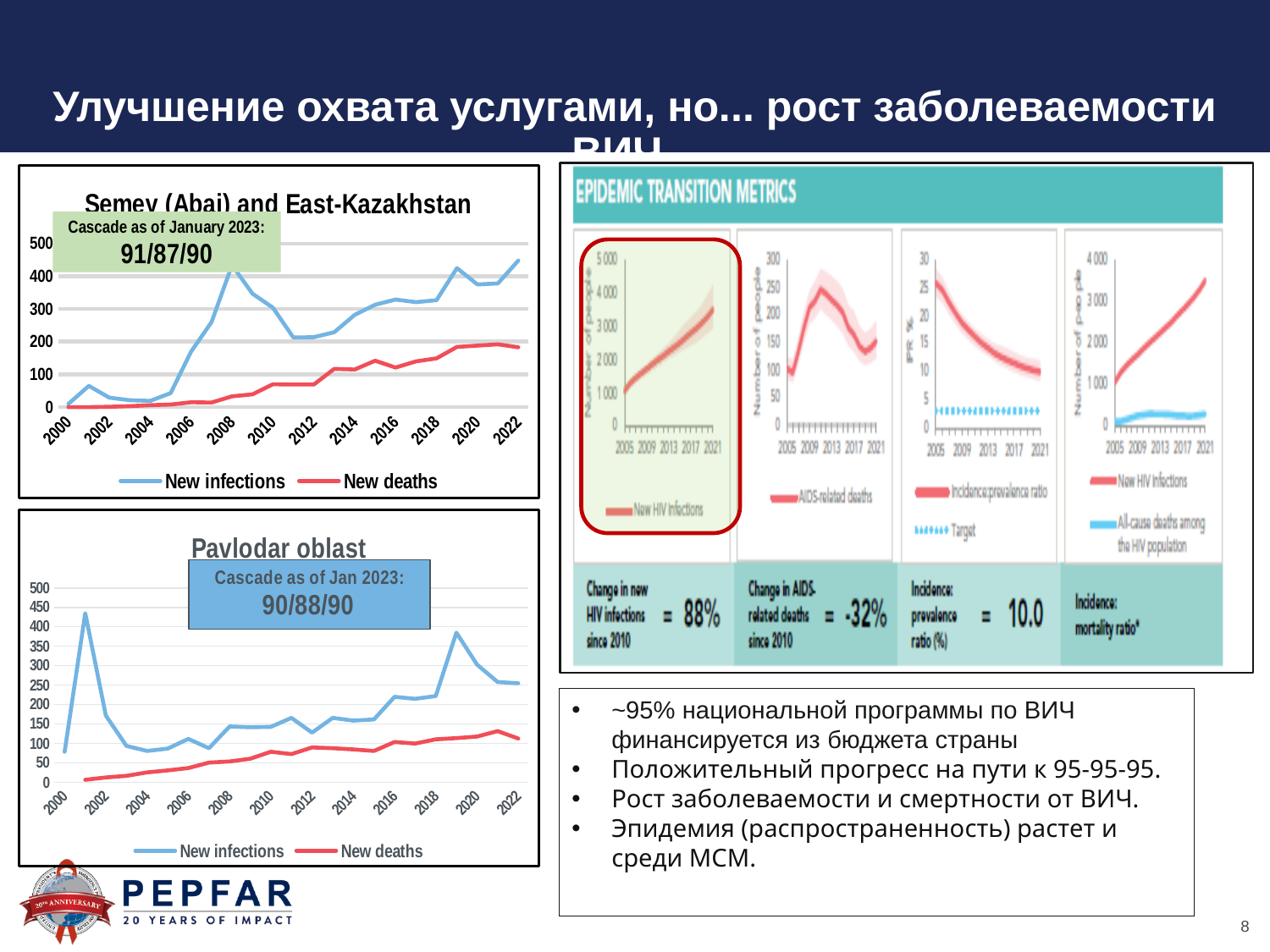
In the 'Semey (Abai) and East-Kazakhstan' chart, is the value for New infections in 2022 greater or less than 400? greater What kind of chart is the 'Semey (Abai) and East-Kazakhstan' chart? Line chart In the 'Pavlodar oblast' chart, is the value for New deaths in 2022 greater or less than 150? less In the 'Pavlodar oblast' chart, in which year do New infections reach their highest value? 2001 In the 'Epidemic Transition Metrics' panel, what is the change in new HIV infections since 2010? 88% In the 'Pavlodar oblast' chart, is the value for New infections in 2022 greater or less than 200? greater In the 'Semey (Abai) and East-Kazakhstan' chart, which series is higher in 2022, New infections or New deaths? New infections In the 'Semey (Abai) and East-Kazakhstan' chart, do New deaths generally rise or fall from 2000 to 2022? Rise In the 'Epidemic Transition Metrics' panel, what is the change in AIDS-related deaths since 2010? -32% What cascade value as of January 2023 is shown on the 'Semey (Abai) and East-Kazakhstan' chart? 91/87/90 How many series does the legend of the 'Pavlodar oblast' chart list? 2